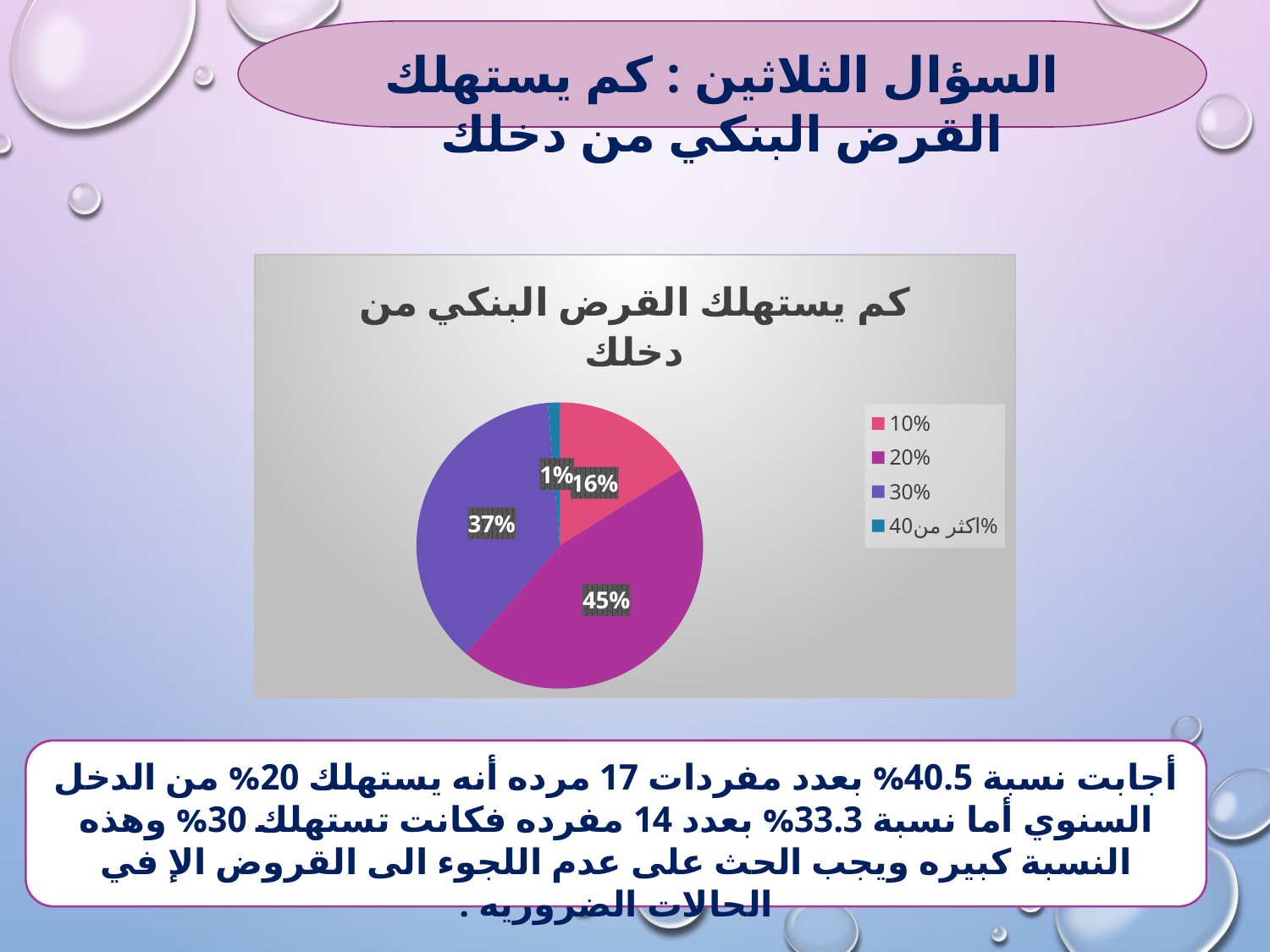
Which category has the largest slice of the pie? 20% What is the title of the chart? كم يستهلك القرض البنكي من دخلك What kind of chart is shown on the slide? pie chart How many categories does the pie chart have? 4 Which category has the smallest slice of the pie? اكثر من 40% How many entries does the legend list? 4 What share of the pie does the 20% category take? 45% What is the difference between the shares of the 20% and 30% categories? 8% What share of the pie does the 10% category take? 16% Which slice is larger, the 10% category or the 30% category? 30% What share of the pie does the 30% category take? 37% What share of the pie does the 'اكثر من 40%' category take? 1%